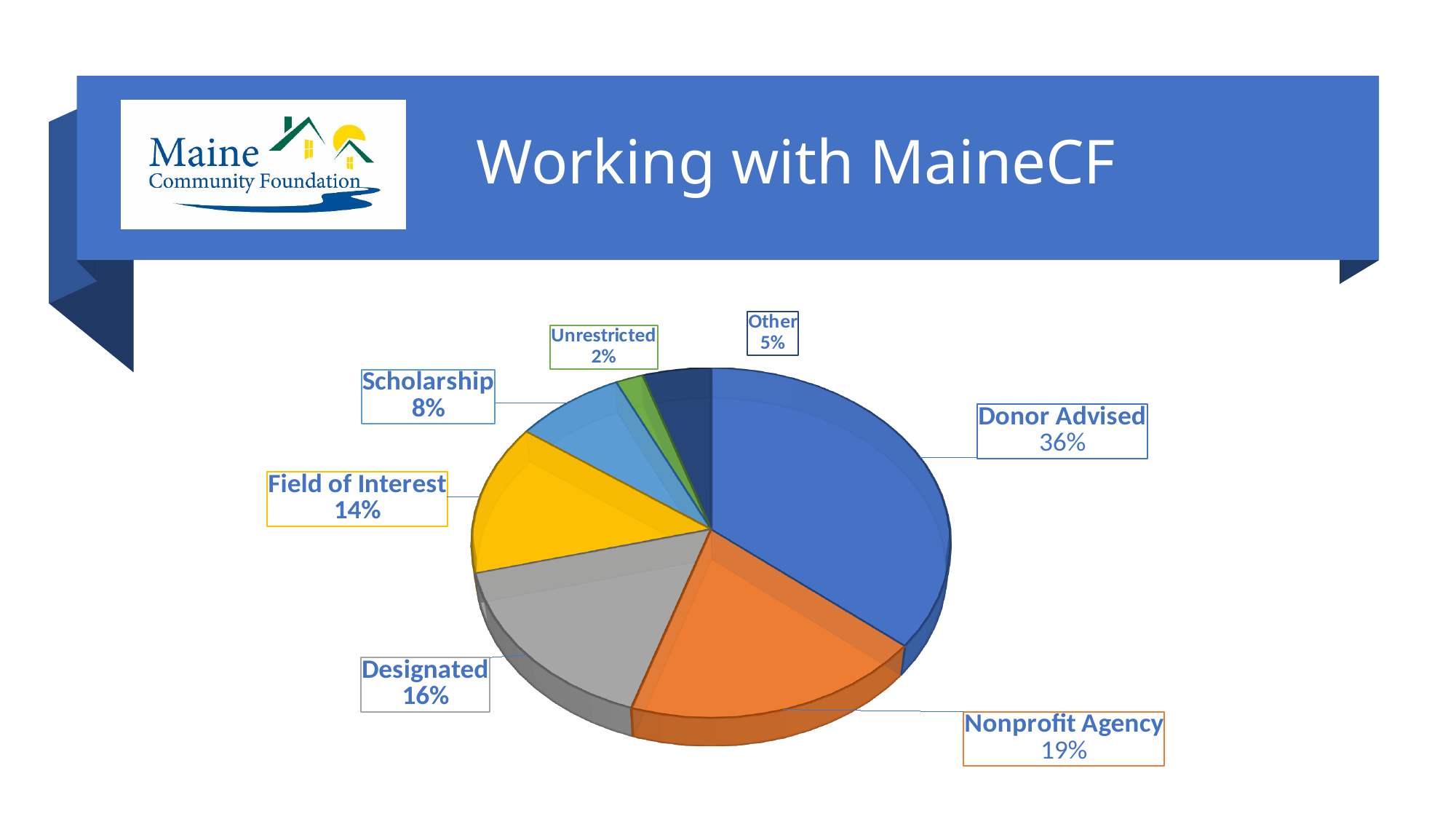
What is the combined share of Scholarship and Other? 13% What percentage is shown for Nonprofit Agency? 19% What colour is the Field of Interest slice? yellow How many slices does the pie chart have? 7 Which category has the largest slice of the pie? Donor Advised Which is larger, Designated or Field of Interest? Designated What share of the pie is Donor Advised? 36% What is the difference in percentage points between Donor Advised and Nonprofit Agency? 17 What kind of chart is shown on the slide? pie chart Which category has the smallest slice of the pie? Unrestricted What is the value for Field of Interest? 14% What percentage is labelled for Unrestricted? 2%